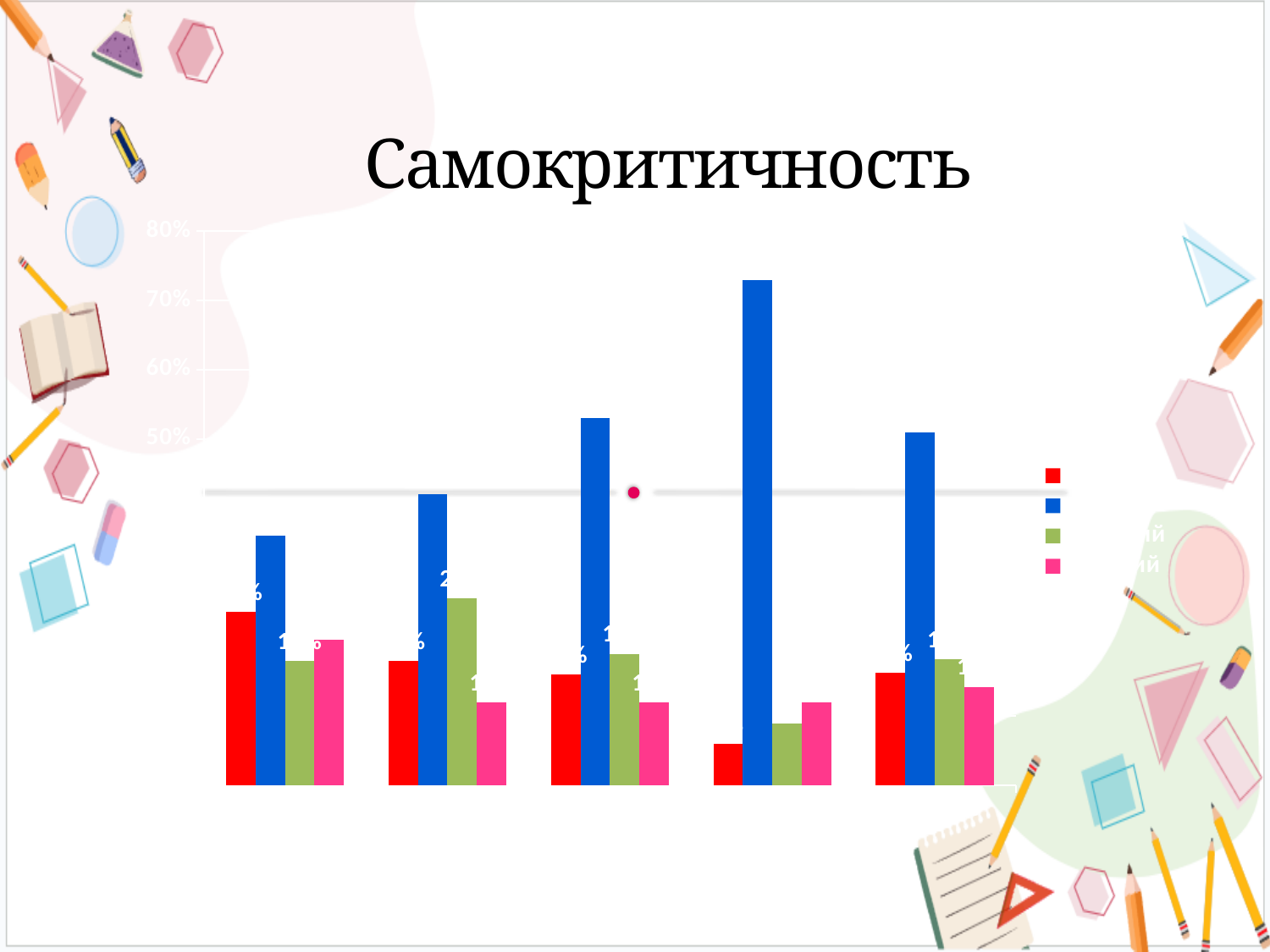
Is the value of the blue bar in the fourth group from the left greater or less than 70%? greater Is the value of the blue bar in the first group from the left greater or less than 50%? less Is the value of the blue bar in the second group from the left greater or less than 50%? less Which colour series has the tallest bar in every group? blue How many series does the legend list? 4 In the fourth group from the left, which is larger: the blue bar or the red bar? the blue bar How many groups of bars are plotted along the x axis? 5 What is the title of the chart? Самокритичность Which group of bars (counting from the left) has the shortest red bar? the fourth group What kind of chart is shown on the slide? bar chart Which group of bars (counting from the left) contains the tallest bar on the chart? the fourth group